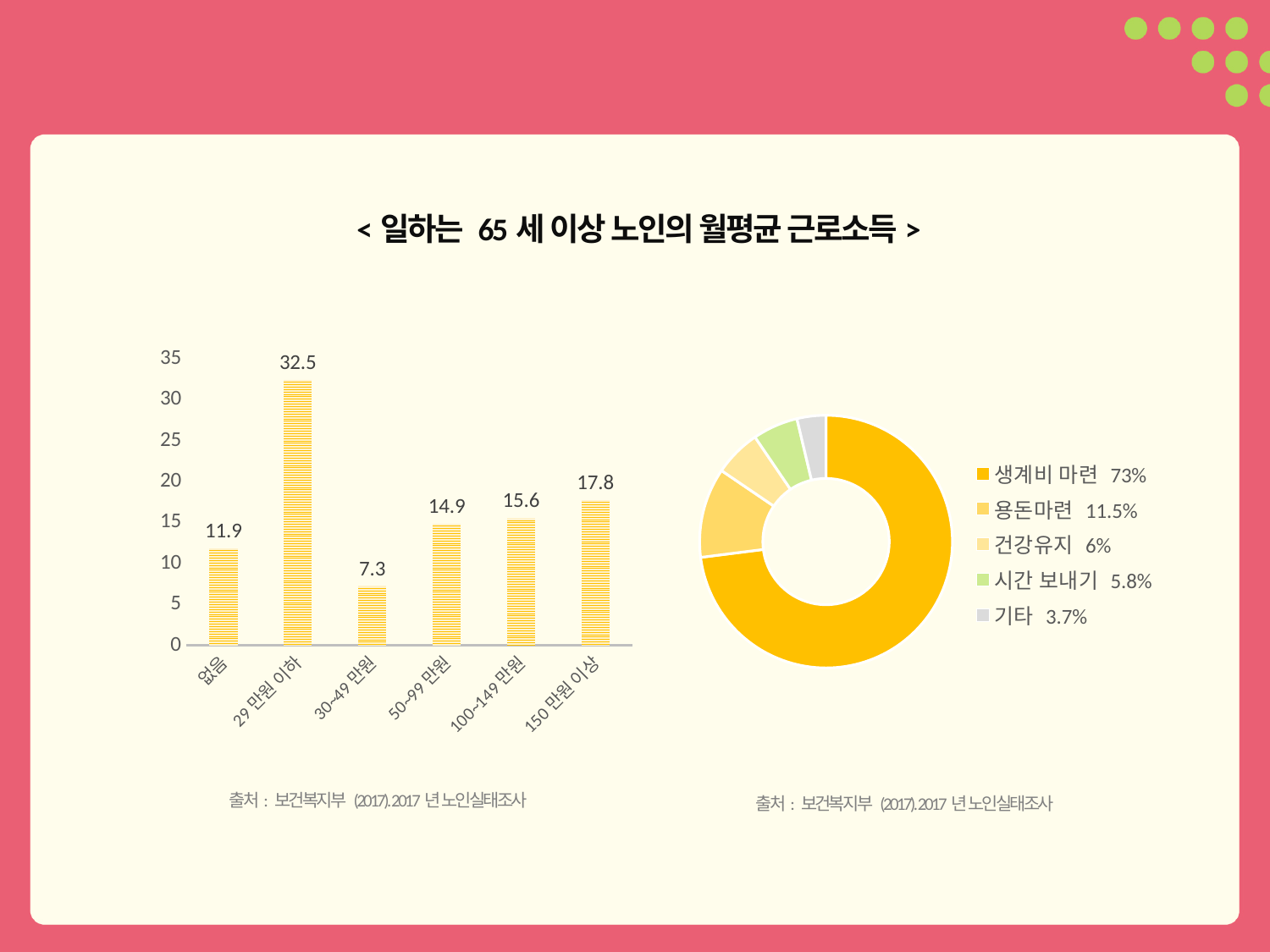
How many entries does the legend of the donut chart on the right list? 5 In the bar chart on the left, which category has the lowest value? 30~49 만원 How many categories are shown in the bar chart on the left? 6 In the donut chart on the right, what share does 생계비 마련 have? 73% In the bar chart on the left, which category has the highest value? 29 만원 이하 In the bar chart on the left, which is larger: the value for 100~149 만원 or the value for 50~99 만원? 100~149 만원 In the donut chart on the right, what is the value for 시간 보내기? 5.8% In the bar chart on the left, what is the value for 29 만원 이하? 32.5 In the bar chart on the left, what is the value for 150 만원 이상? 17.8 In the donut chart on the right, which category has the smallest share? 기타 What type of chart is shown on the left side of the slide? Bar chart In the bar chart on the left, what is the difference between the values for 29 만원 이하 and 없음? 20.6